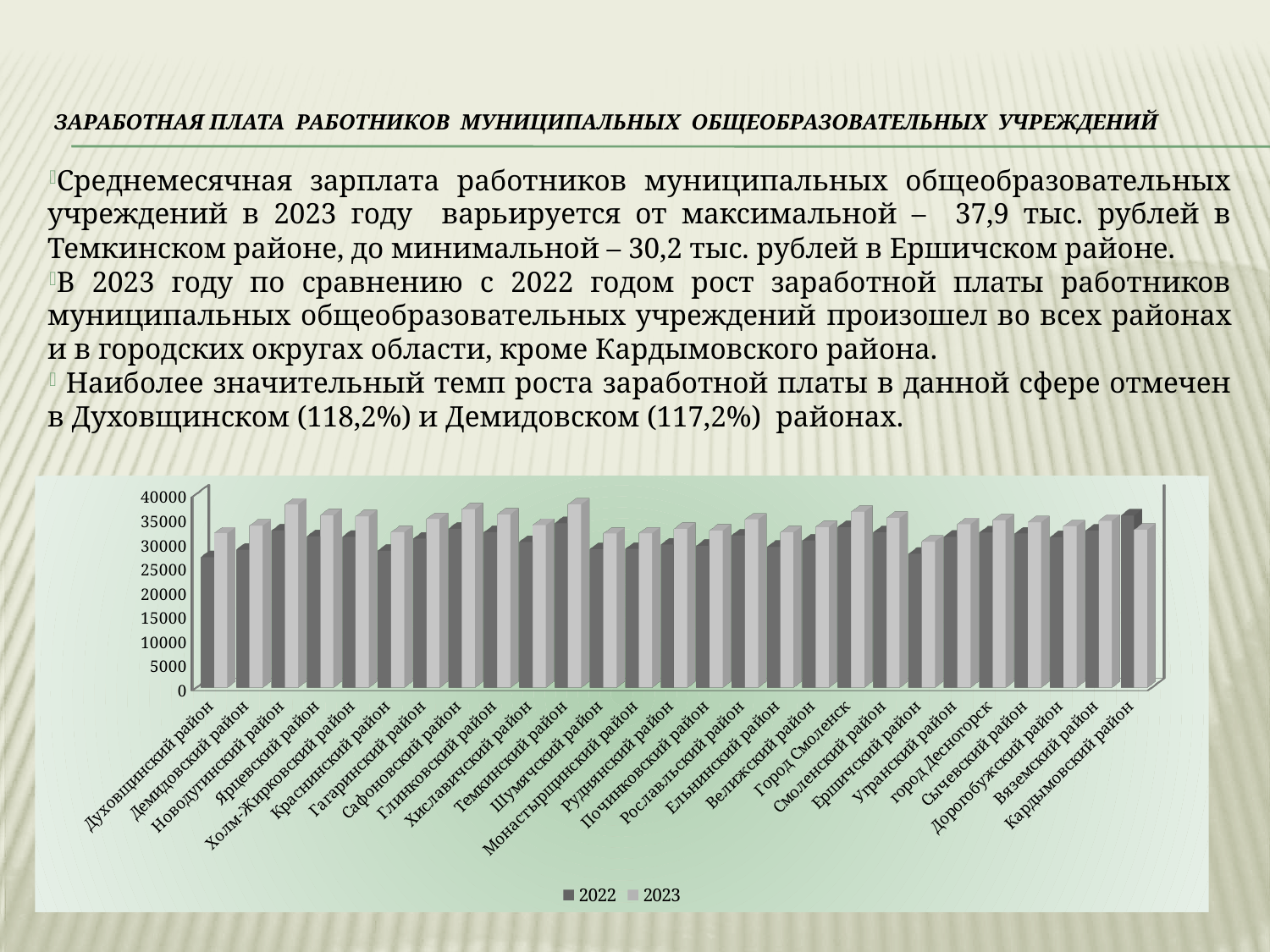
Which district has the highest 2023 value in the chart? Темкинский район For Духовщинский район, which is larger: the 2022 value or the 2023 value? 2023 What kind of chart is shown on the slide? bar chart Is the 2022 value for Духовщинский район greater or less than 30000? less Is the 2023 value for Темкинский район greater or less than 35000? greater How many series does the chart legend list? 2 Which years are listed in the chart legend? 2022 and 2023 Is the 2022 value for Ершичский район greater or less than 30000? less For Кардымовский район, which is larger: the 2022 value or the 2023 value? 2022 Which district has the lowest 2023 value in the chart? Ершичский район How many districts (categories) are shown on the x axis of the chart? 27 Which series is drawn in the darker grey bars? 2022